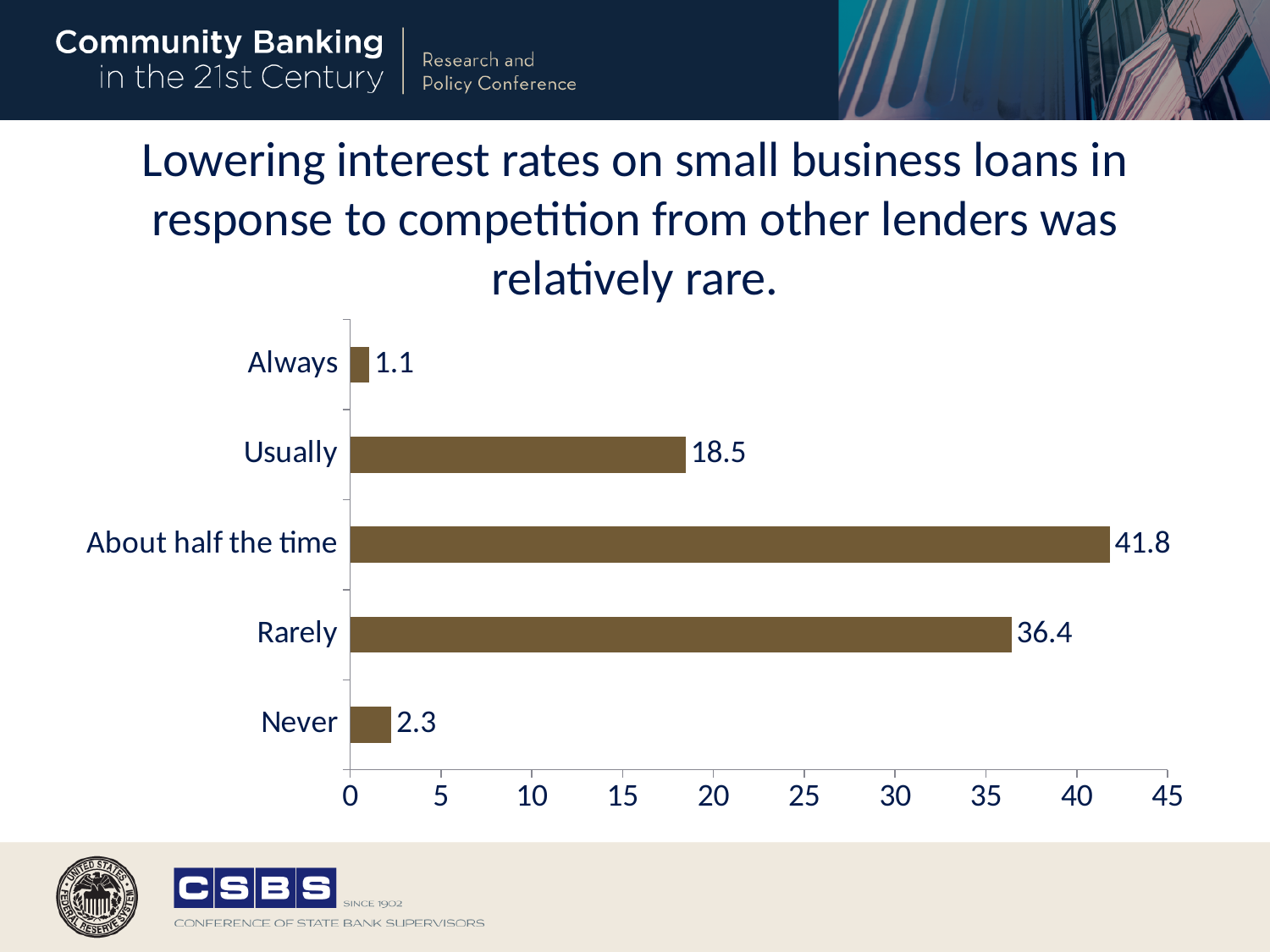
Which category has the lowest value? Always What kind of chart is shown on the slide? bar chart What is the maximum value shown on the horizontal axis? 45 Which is larger, the value for "Usually" or the value for "Rarely"? Rarely Which category has the highest value? About half the time What is the difference between the values for "About half the time" and "Rarely"? 5.4 Is the value for "Usually" greater or less than 20? less What is the value for "About half the time"? 41.8 What is the value for "Rarely"? 36.4 How many categories are shown in the chart? 5 What is the value for "Usually"? 18.5 What is the value for "Never"? 2.3